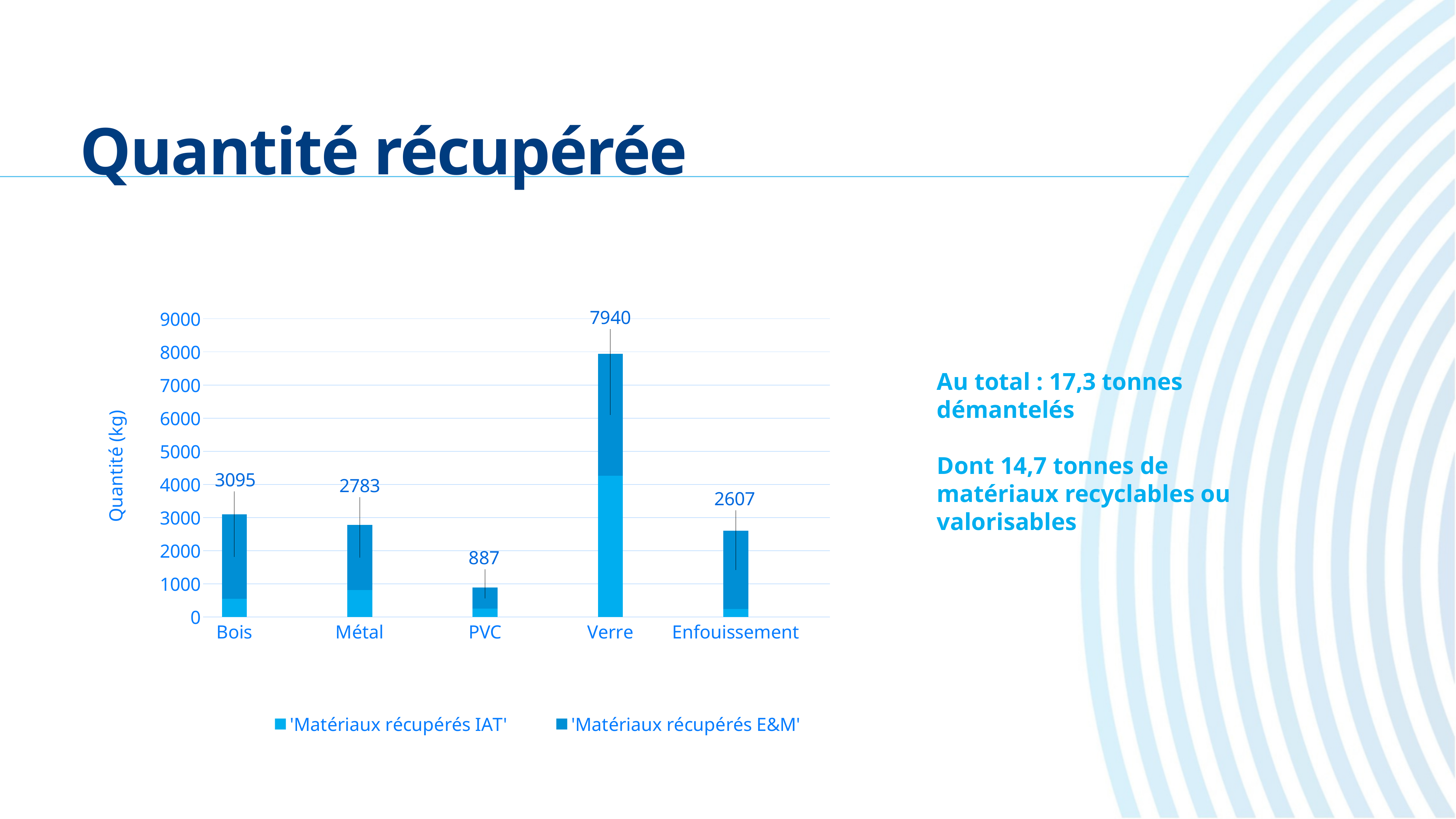
What is the total value labelled for the PVC bar? 887 How many categories are shown on the x axis? 5 What is the difference between the total for Verre and the total for Bois? 4845 What kind of chart is shown on the slide? Stacked bar chart Which has a larger total, Métal or Enfouissement? Métal What is the total value labelled for the Verre bar? 7940 What is the total value labelled for the Bois bar? 3095 What is the total value labelled for the Enfouissement bar? 2607 How many series does the legend list? 2 Is the 'Matériaux récupérés IAT' value for Bois greater or less than 1000? less Which category has the lowest total quantity? PVC Which category has the highest total quantity? Verre